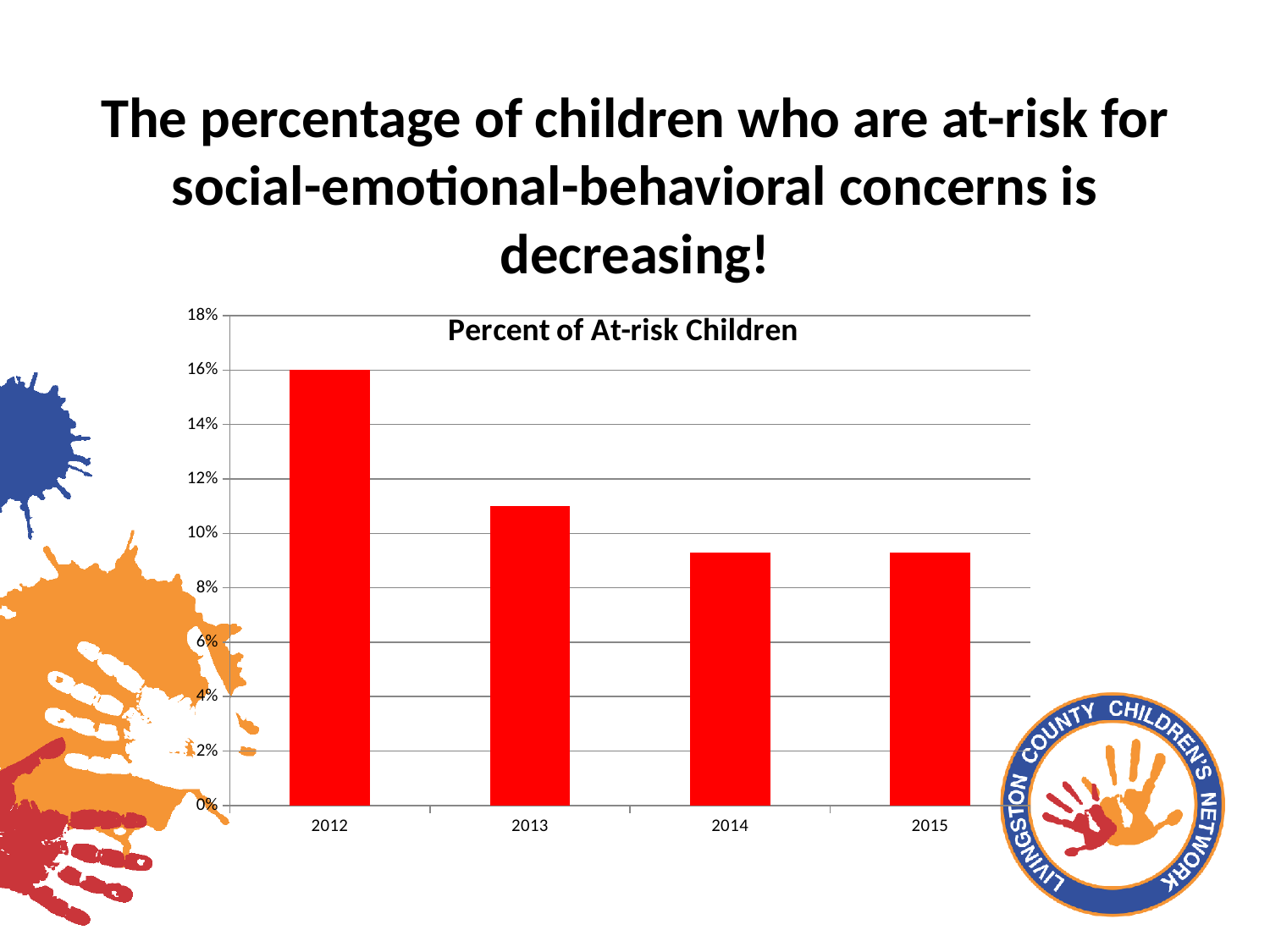
Which year has the highest percent of at-risk children? 2012 Which is larger, the value for 2012 or the value for 2013? 2012 What colour are the bars in the chart? red How many years are shown on the x axis of the chart? 4 Do the values generally rise or fall from 2012 to 2015? fall What is the title of the chart? Percent of At-risk Children Is the value for 2015 greater or less than 8%? greater Is the value for 2013 greater or less than 12%? less What is the percent of at-risk children in 2012? 16% Is the value for 2013 greater or less than 10%? greater What type of chart is shown on the slide? bar chart